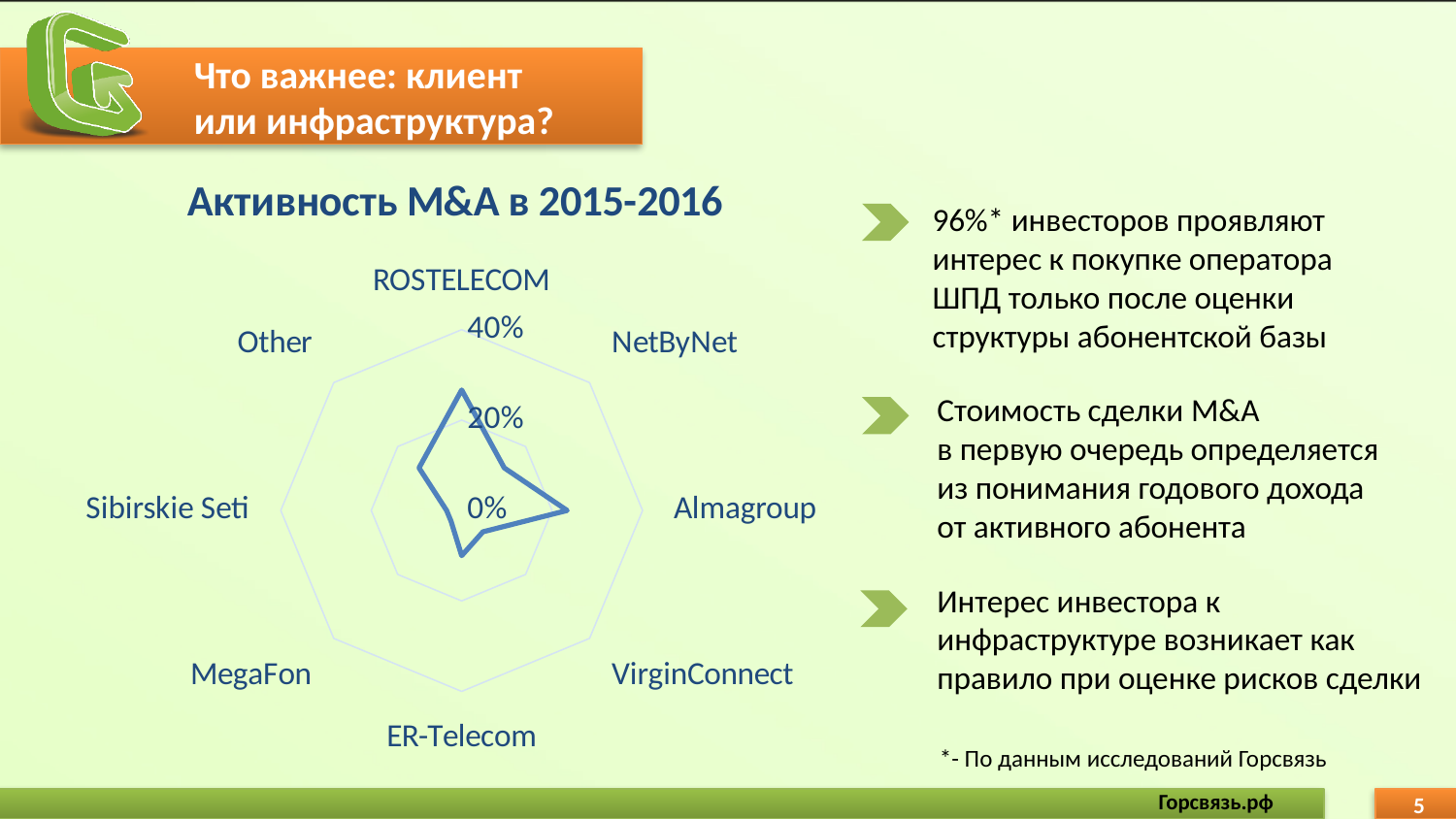
Which is larger, the value for Almagroup or the value for Other? Almagroup Which is larger, the value for ROSTELECOM or the value for MegaFon? ROSTELECOM Is the value for ROSTELECOM greater or less than 40%? less How many categories (companies) are plotted on the radar chart? 8 What is the highest percentage tick shown on the radar chart's axis? 40% Which company has the highest value on the radar chart? ROSTELECOM Is the value for ER-Telecom greater or less than 20%? less Is the value for Other greater or less than 20%? less What kind of chart is shown on the slide? Radar chart What is the title of the chart? Активность M&A в 2015-2016